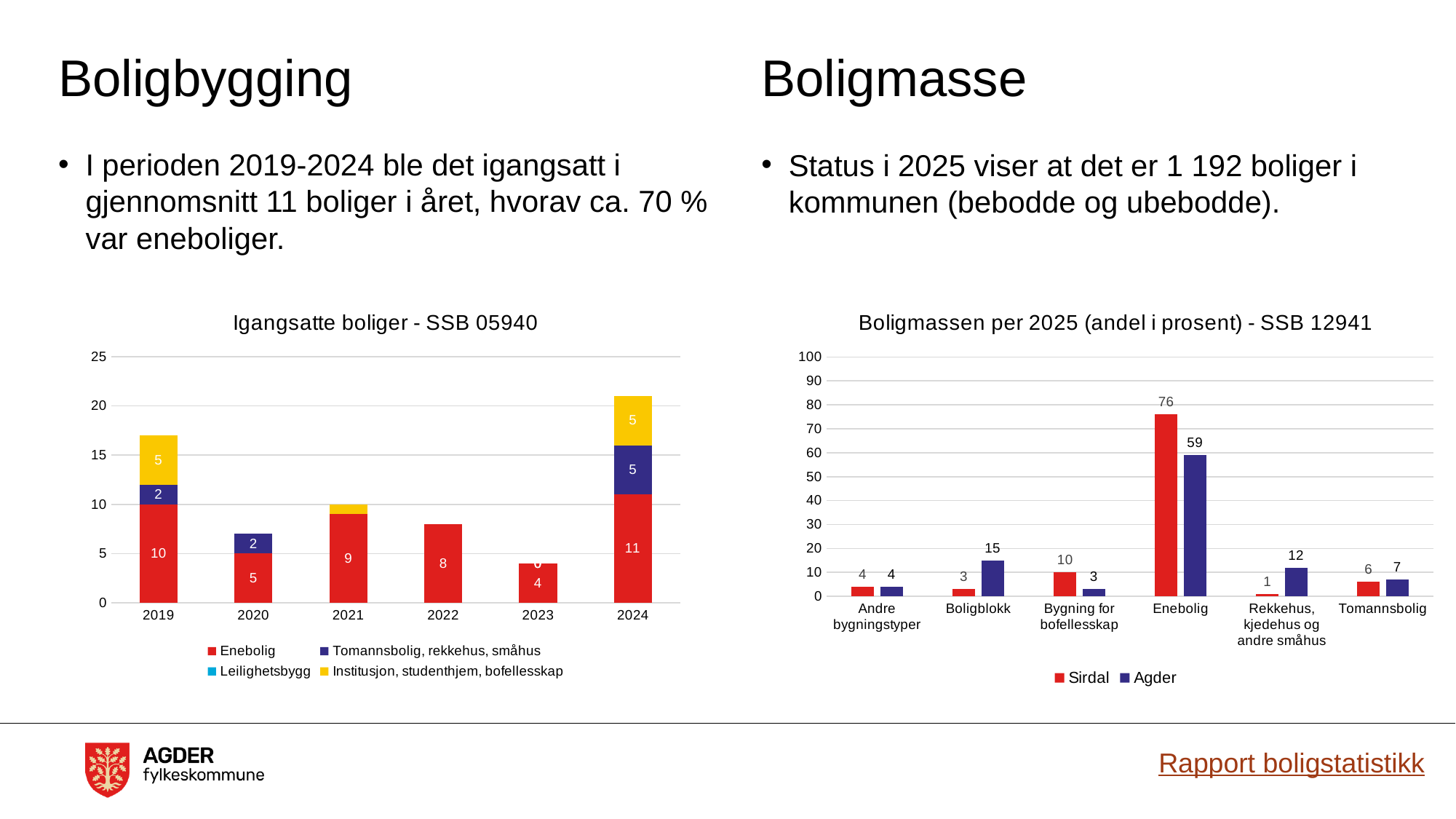
In the chart titled 'Boligmassen per 2025 (andel i prosent) - SSB 12941', which category has the lowest Sirdal value? Rekkehus, kjedehus og andre småhus What kind of chart is 'Boligmassen per 2025 (andel i prosent) - SSB 12941'? Bar chart In the chart titled 'Boligmassen per 2025 (andel i prosent) - SSB 12941', which is larger for Boligblokk, Sirdal or Agder? Agder In the chart titled 'Igangsatte boliger - SSB 05940', what is the difference between the Enebolig values for 2019 and 2020? 5 In the chart titled 'Igangsatte boliger - SSB 05940', how many years are shown on the x axis? 6 In the chart titled 'Igangsatte boliger - SSB 05940', what is the total of the stacked bar for 2024? 21 In the chart titled 'Igangsatte boliger - SSB 05940', what is the total of the stacked bar for 2019? 17 In the chart titled 'Boligmassen per 2025 (andel i prosent) - SSB 12941', what is the difference between the Sirdal and Agder values for Enebolig? 17 In the chart titled 'Boligmassen per 2025 (andel i prosent) - SSB 12941', which category has the highest Agder value? Enebolig In the chart titled 'Igangsatte boliger - SSB 05940', what is the Enebolig value for 2024? 11 In the chart titled 'Igangsatte boliger - SSB 05940', how many series does the legend list? 4 In the chart titled 'Boligmassen per 2025 (andel i prosent) - SSB 12941', what is the Sirdal value for Enebolig? 76